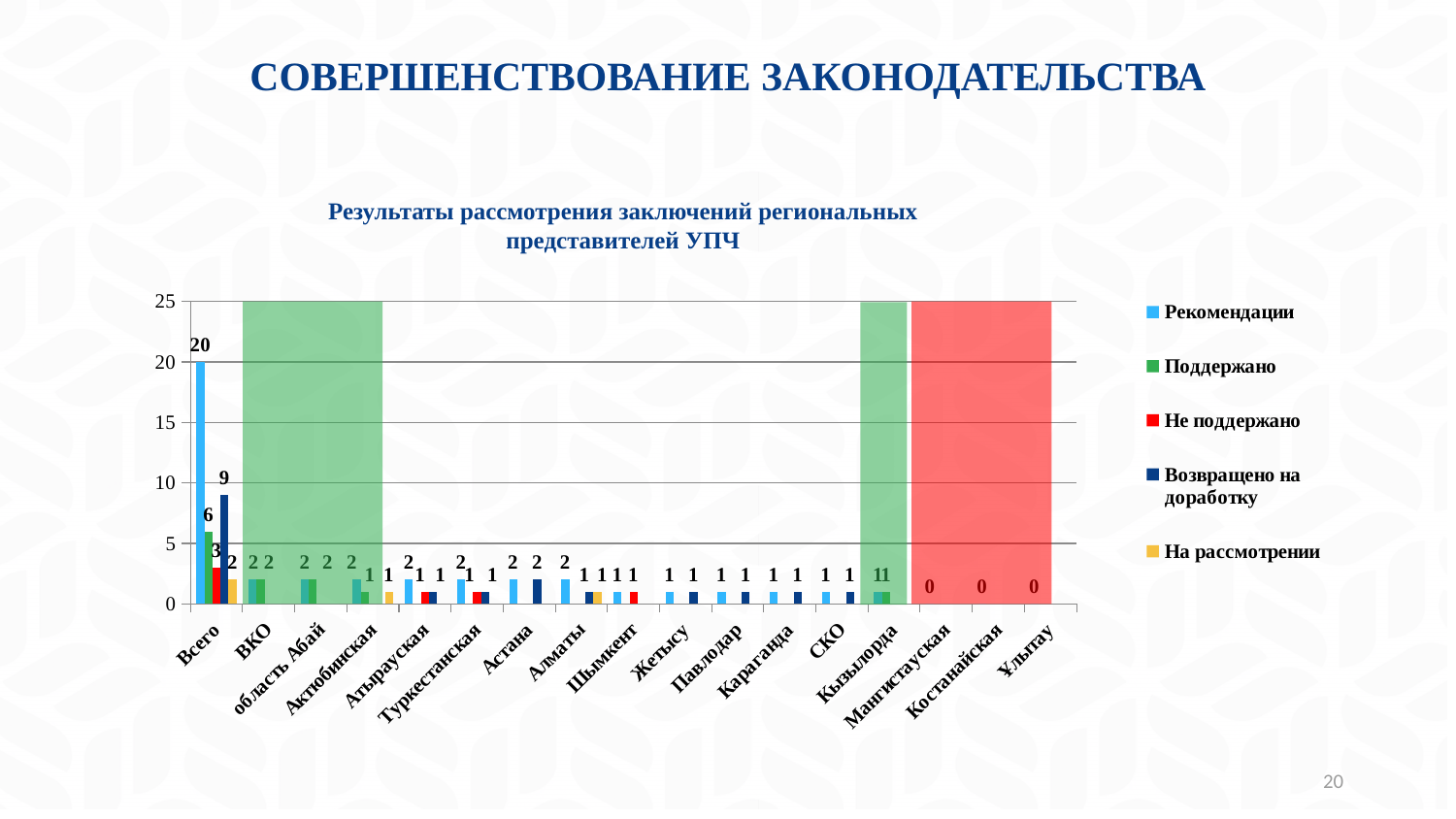
What is the value of Рекомендации for Всего? 20 Which category has the highest value for Рекомендации? Всего What is the value of Возвращено на доработку for Всего? 9 What is the title of the chart? Результаты рассмотрения заключений региональных представителей УПЧ What is the value of Не поддержано for Всего? 3 What value is shown for Мангистауская? 0 How many series does the legend list? 5 How many categories are shown on the x axis? 17 What kind of chart is shown on the slide? bar chart For Всего, which is larger: Поддержано or Возвращено на доработку? Возвращено на доработку What is the value of Поддержано for Всего? 6 What is the difference between Рекомендации and Возвращено на доработку for Всего? 11